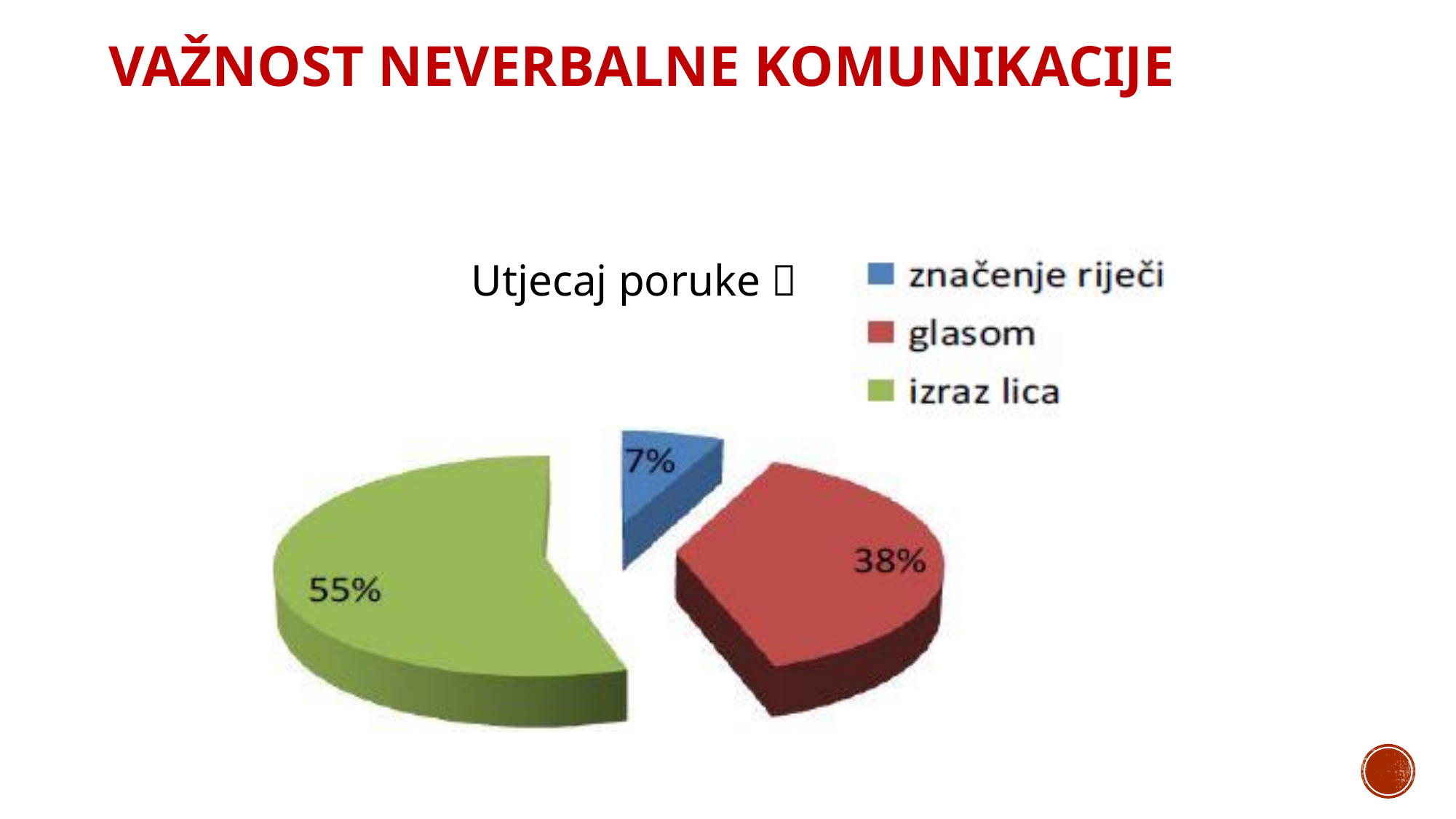
Which legend entry is shown in blue? značenje riječi What share of the pie does 'glasom' represent? 38% Which category has the smallest slice of the pie? značenje riječi What is the difference in percentage points between 'izraz lica' and 'glasom'? 17 What is the difference in percentage points between 'glasom' and 'značenje riječi'? 31 How many slices does the pie chart have? 3 What share of the pie does 'značenje riječi' represent? 7% What colour is the slice for 'glasom'? red Which category has the largest slice of the pie? izraz lica Which is larger, the slice for 'glasom' or the slice for 'značenje riječi'? glasom What share of the pie does 'izraz lica' represent? 55% What kind of chart is shown on the slide? pie chart